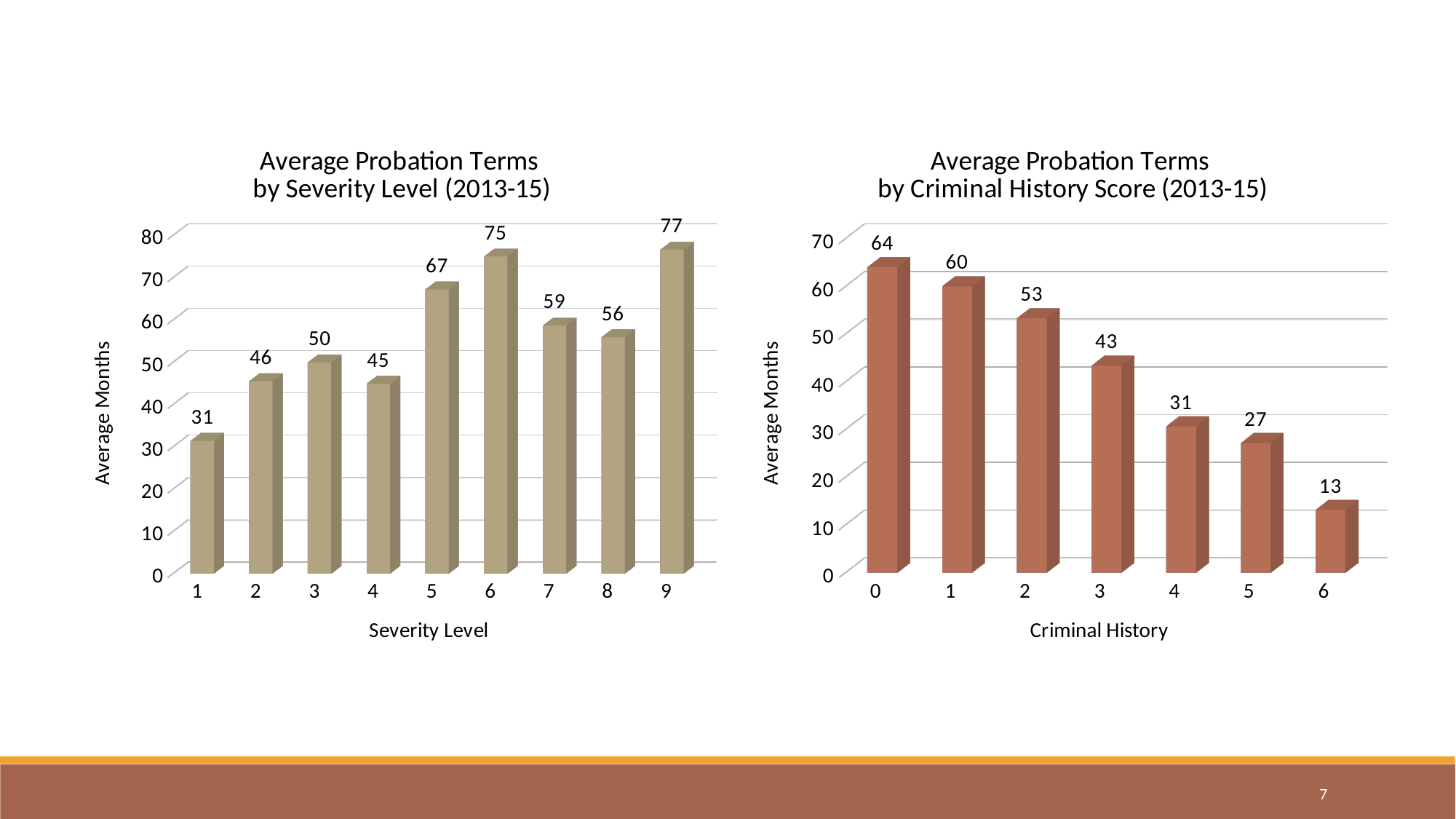
In the 'Average Probation Terms by Criminal History Score (2013-15)' chart, what is the difference in average months between criminal history score 0 and criminal history score 6? 51 In the 'Average Probation Terms by Severity Level (2013-15)' chart, which severity level has the lowest average probation term? 1 In the 'Average Probation Terms by Severity Level (2013-15)' chart, what is the difference in average months between severity level 6 and severity level 4? 30 In the 'Average Probation Terms by Criminal History Score (2013-15)' chart, do the values rise or fall as the criminal history score increases? Fall In the 'Average Probation Terms by Criminal History Score (2013-15)' chart, what is the average number of months for criminal history score 3? 43 In the 'Average Probation Terms by Criminal History Score (2013-15)' chart, how many criminal history scores are shown? 7 In the 'Average Probation Terms by Severity Level (2013-15)' chart, which severity level has the highest average probation term? 9 In the 'Average Probation Terms by Criminal History Score (2013-15)' chart, which criminal history score has the lowest average probation term? 6 In the 'Average Probation Terms by Severity Level (2013-15)' chart, which is larger: the value for severity level 7 or severity level 8? Severity level 7 In the 'Average Probation Terms by Severity Level (2013-15)' chart, what is the average number of months for severity level 5? 67 What kind of chart is the 'Average Probation Terms by Criminal History Score (2013-15)' chart? Bar chart In the 'Average Probation Terms by Severity Level (2013-15)' chart, how many severity levels are shown? 9